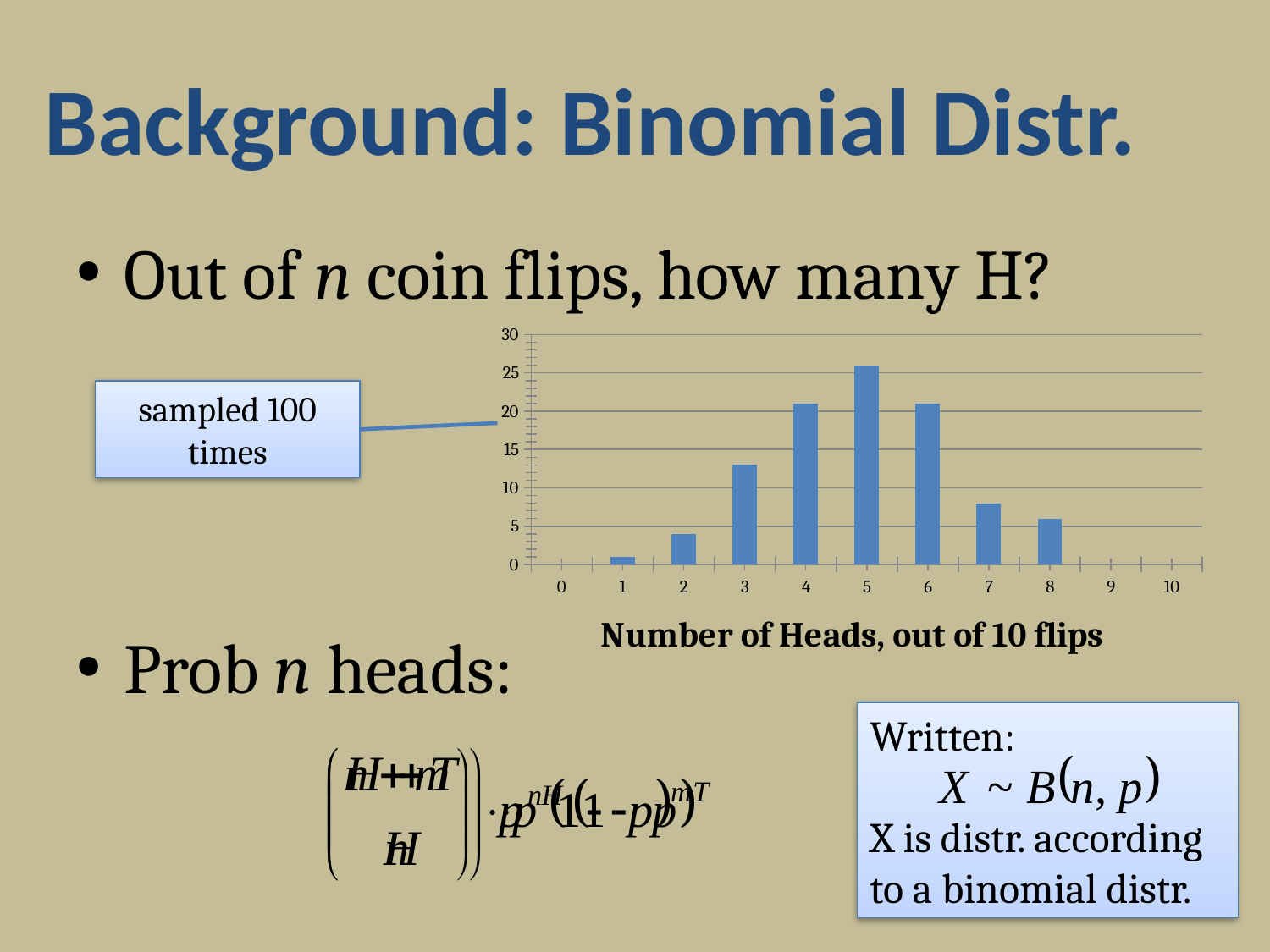
How many categories are shown along the x axis of the chart? 11 Is the value for 3 heads greater or less than 15? less Is the value for 5 heads greater or less than 20? greater Do the bar values rise or fall as the number of heads goes from 5 to 8? fall Which has a larger value in the chart, 3 heads or 8 heads? 3 heads What is the title shown below the chart's x axis? Number of Heads, out of 10 flips Is the value for 2 heads greater or less than 5? less Which has a larger value in the chart, 4 heads or 7 heads? 4 heads Which number of heads has the highest bar in the chart? 5 What kind of chart is shown on the slide? bar chart